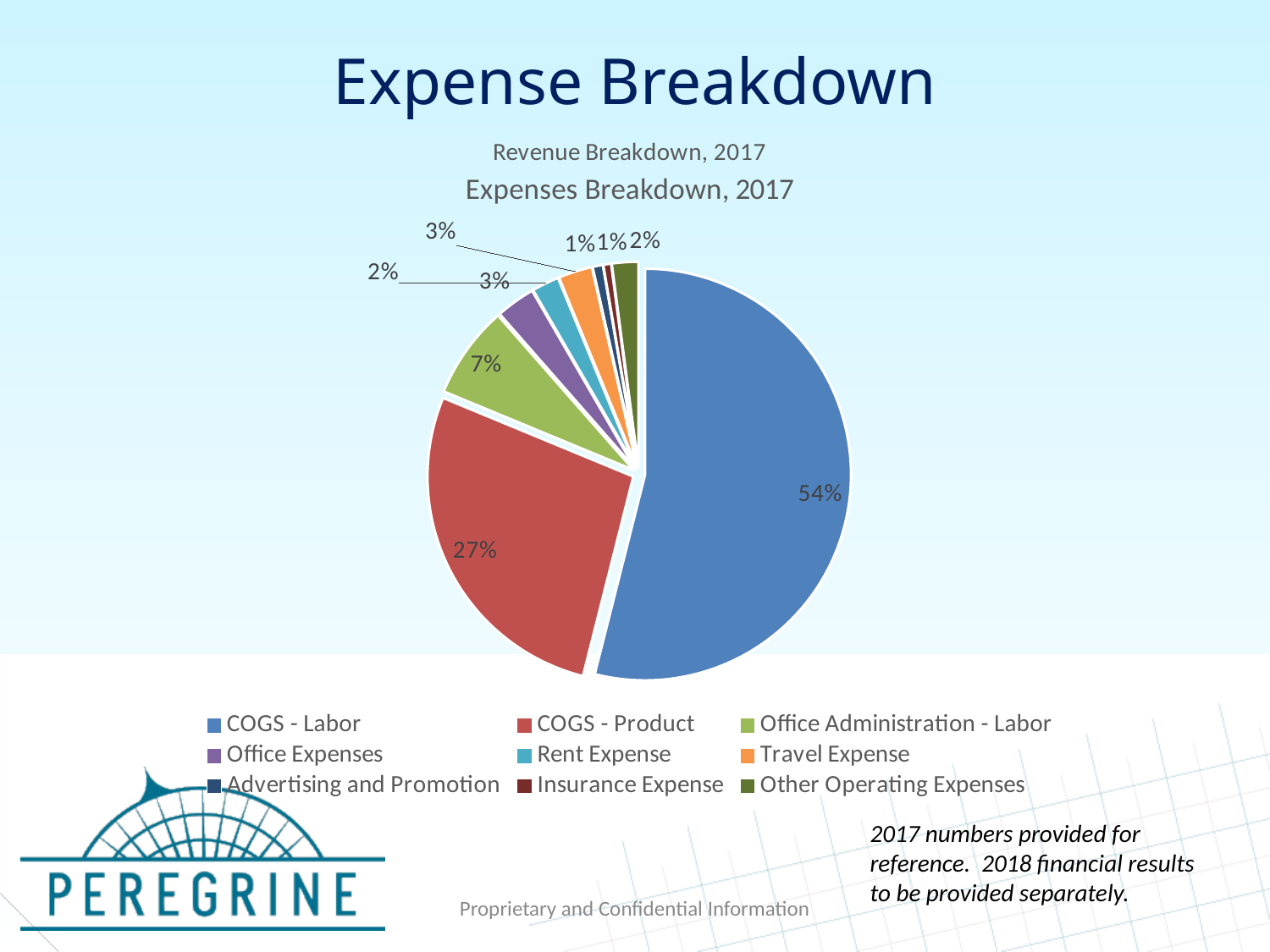
Which colour represents COGS - Product in the legend? Red What is the difference in percentage points between COGS - Labor and COGS - Product? 27 Which expense category has the largest share of the pie? COGS - Labor How many expense categories are shown in the pie chart? 9 Which is larger, COGS - Product or Office Administration - Labor? COGS - Product What percentage of the pie does Office Expenses represent? 3% What percentage of the pie does COGS - Labor represent? 54% What percentage of the pie does COGS - Product represent? 27% What is the title of the chart? Expenses Breakdown, 2017 What percentage of the pie does Office Administration - Labor represent? 7% What kind of chart is shown on the slide? Pie chart What share of total expenses is COGS - Labor? 54%